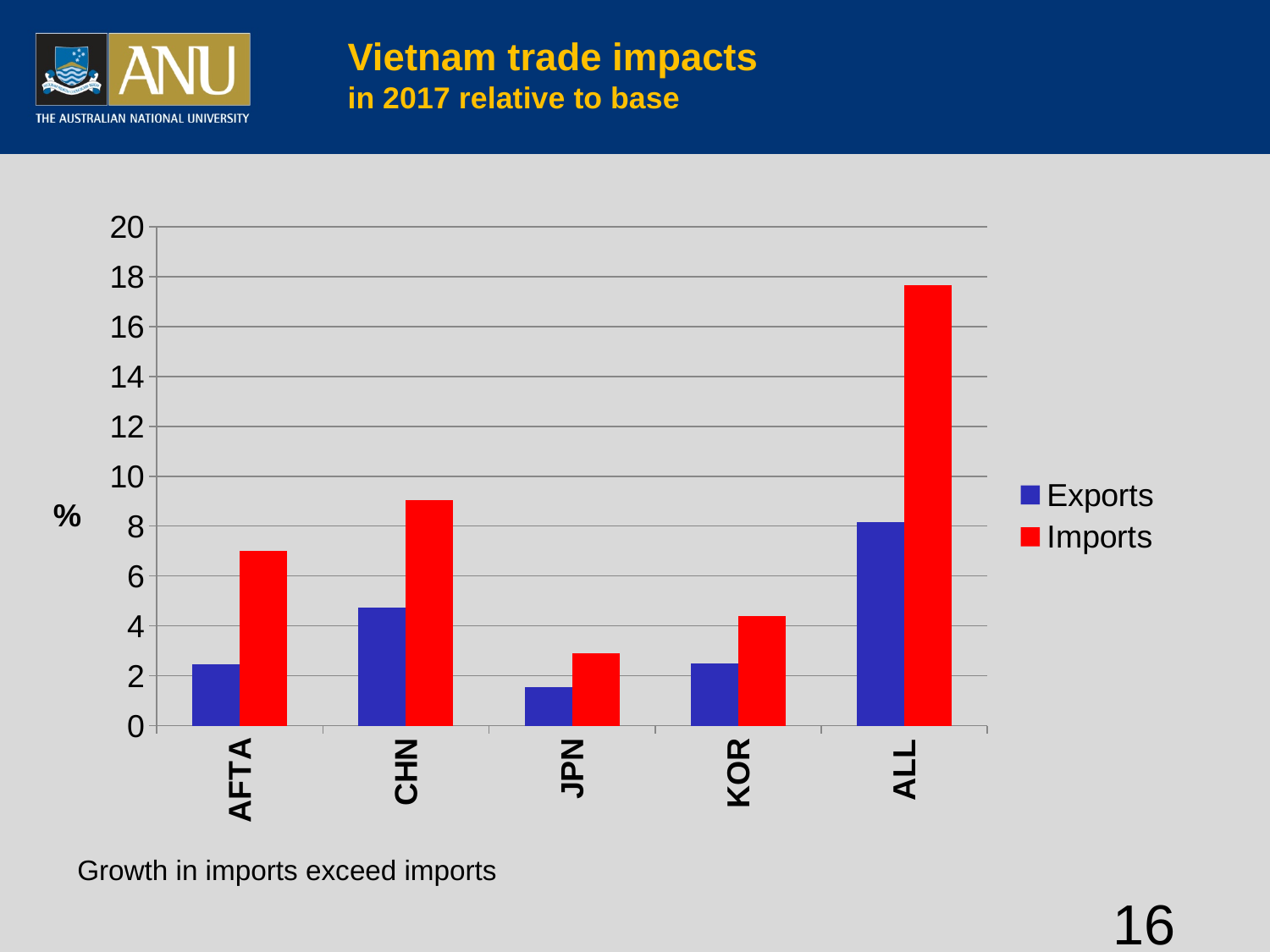
How many series does the legend list? 2 What kind of chart is shown on the slide? bar chart Which is larger, the Exports value for ALL or the Imports value for CHN? Imports value for CHN Is the Exports value for CHN greater or less than 4? greater Is the Imports value for ALL greater or less than 16? greater What is the label on the vertical axis? % How many categories are shown on the x axis? 5 Which is larger for AFTA, Exports or Imports? Imports Is the Imports value for JPN greater or less than 4? less Which category has the highest Imports value? ALL Which category has the lowest Imports value? JPN Which category has the lowest Exports value? JPN